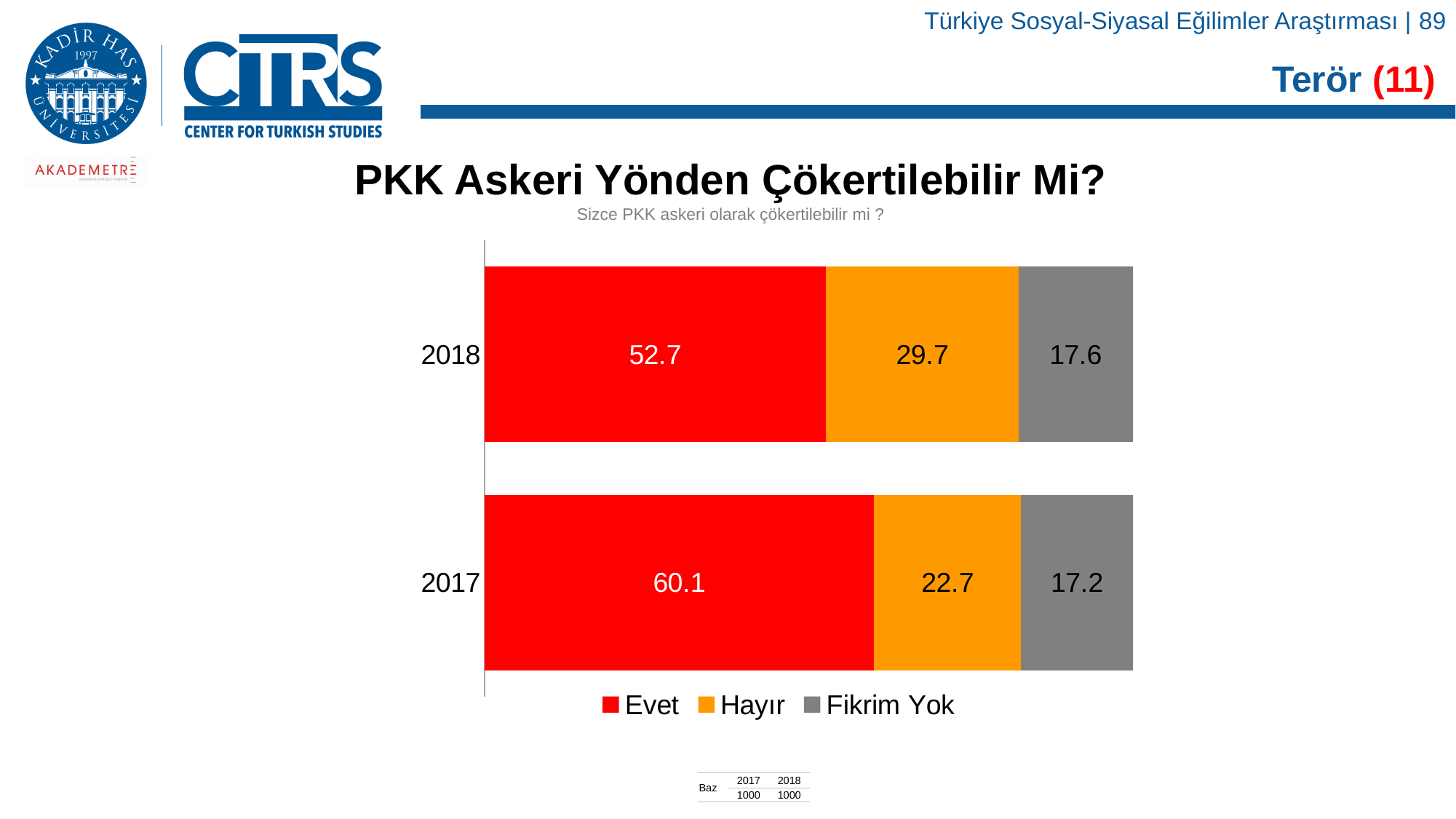
Which response had the lowest value in 2017? Fikrim Yok In which year was the Evet value higher? 2017 What is the value for Hayır in 2017? 22.7 How many years are shown in the chart? 2 How many series does the legend list? 3 What is the value for Fikrim Yok in 2018? 17.6 What is the total of the stacked bar for 2017? 100.0 What is the value for Evet in 2018? 52.7 What is the difference between the Hayır values for 2018 and 2017? 7.0 What kind of chart is shown on the slide? Stacked bar chart What is the difference between the Evet values for 2017 and 2018? 7.4 Is the Hayır value larger in 2018 or in 2017? 2018